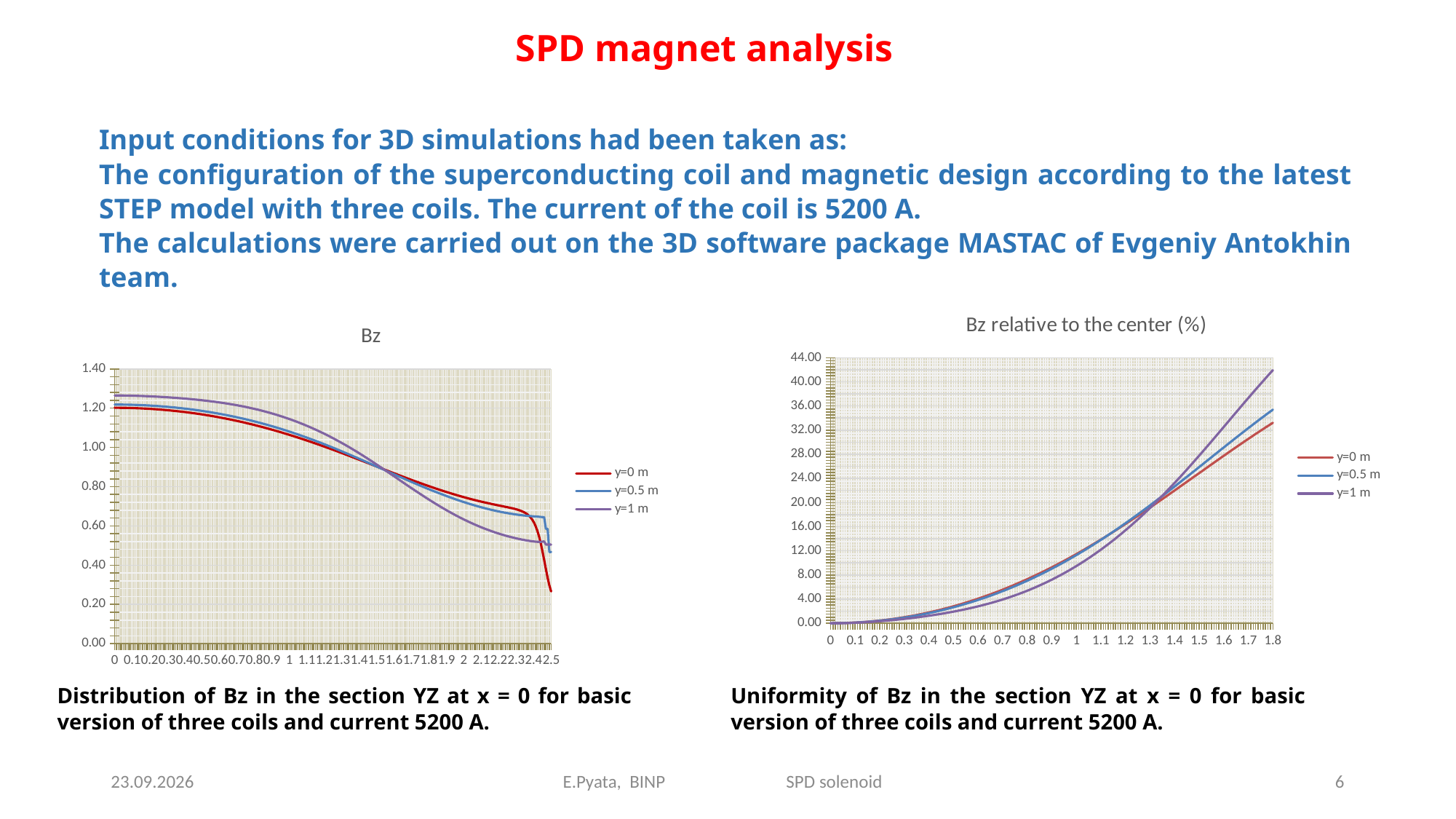
In the left chart "Bz", is the value of the y=1 m series at x = 0 greater or less than 1.20? greater In the left chart "Bz", which series has the lowest value at x = 2? y=1 m In the right chart "Bz relative to the center (%)", is the value of the y=0 m series at x = 1.8 greater or less than 36.00? less In the left chart "Bz", do the values generally rise or fall along the x axis? fall In the right chart "Bz relative to the center (%)", which series has the highest value at x = 1.8? y=1 m In the right chart "Bz relative to the center (%)", is the value of the y=1 m series at x = 1.8 greater or less than 40.00? greater In the right chart "Bz relative to the center (%)", do the values rise or fall along the x axis? rise What kind of chart is the left chart titled "Bz"? line chart How many series does the legend of the right chart "Bz relative to the center (%)" list? 3 What is the title of the right chart? Bz relative to the center (%) In the right chart "Bz relative to the center (%)", which series has the lowest value at x = 0.5? y=1 m